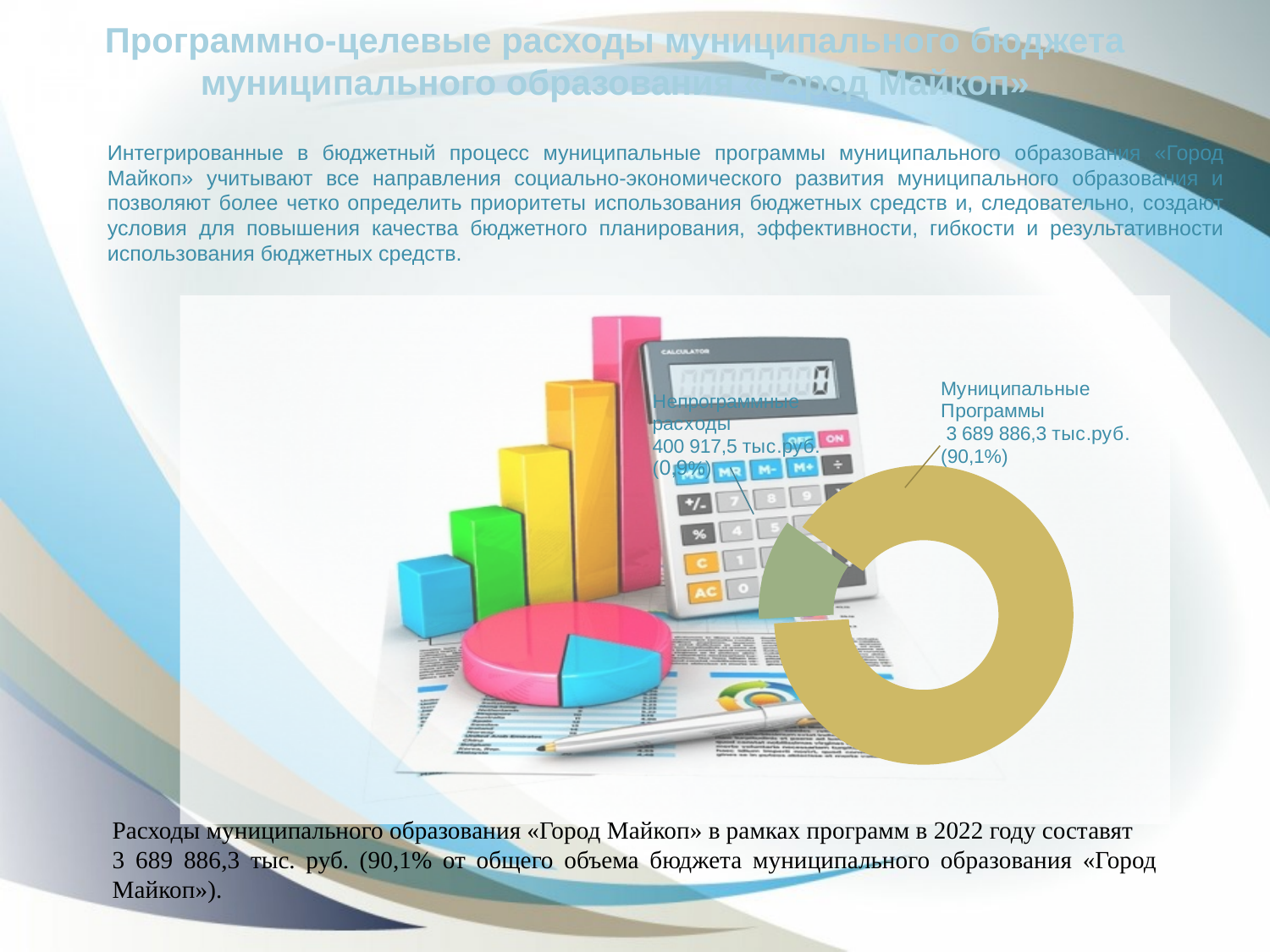
Which slice of the doughnut chart is the largest? Муниципальные Программы What kind of chart is shown on the slide? doughnut chart What colour is the Муниципальные Программы slice in the doughnut chart? gold Which slice of the doughnut chart is the smallest? Непрограммные расходы What is the value shown for Непрограммные расходы in the chart? 400 917,5 тыс.руб. What is the value shown for Муниципальные Программы in the chart? 3 689 886,3 тыс.руб. What colour is the Непрограммные расходы slice in the doughnut chart? green What share of the doughnut chart does Муниципальные Программы represent? 90,1% Which is larger in the chart: Муниципальные Программы or Непрограммные расходы? Муниципальные Программы What percentage is printed next to Непрограммные расходы in the chart? 0,9% How many slices does the doughnut chart have? 2 What is the difference between the values for Муниципальные Программы and Непрограммные расходы in the chart? 3 288 968,8 тыс.руб.